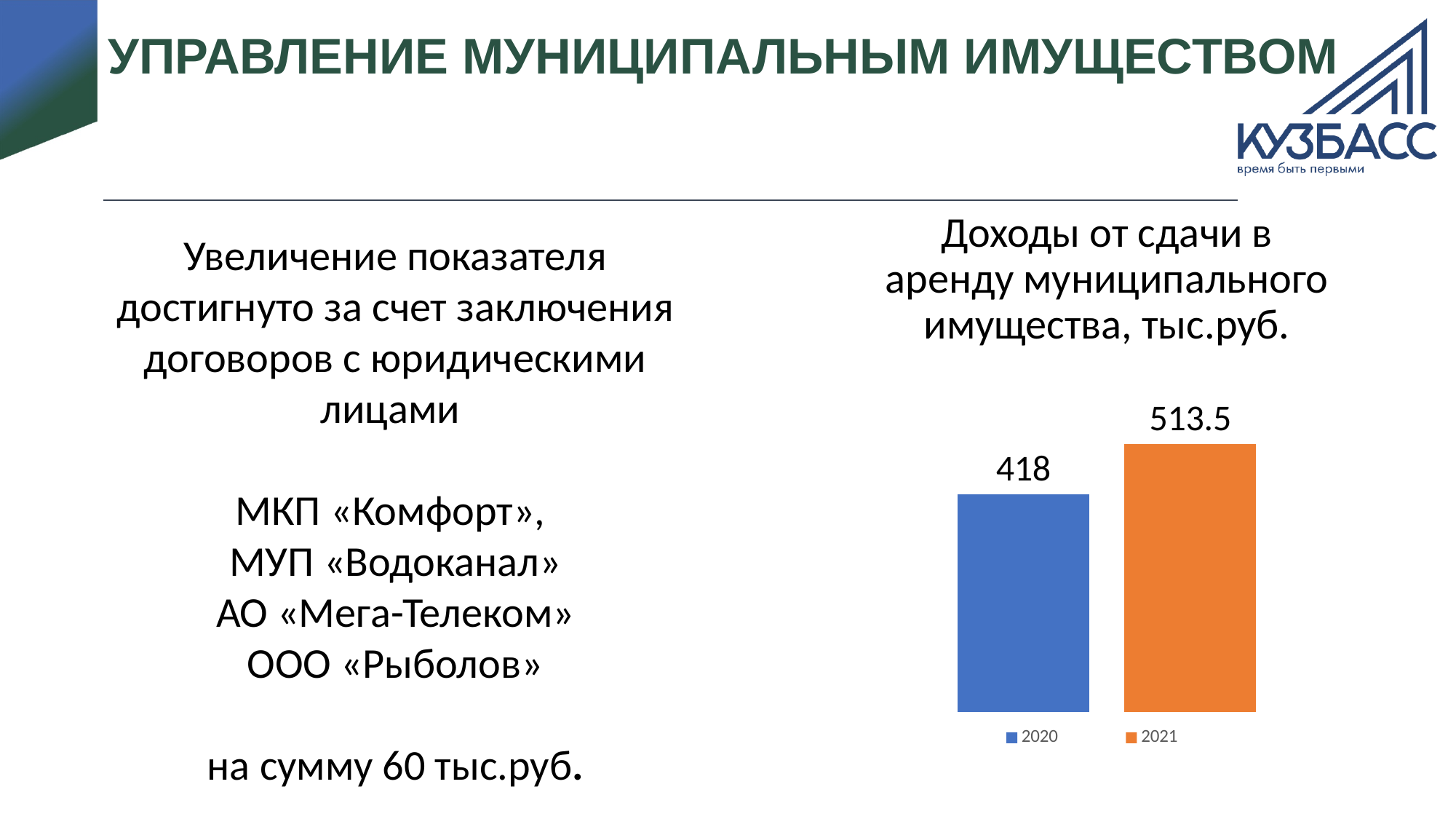
Do the values in the chart rise or fall from 2020 to 2021? rise Which year has the highest value in the chart? 2021 Which year has the lowest value in the chart? 2020 What type of chart is shown on the slide? bar chart What is the value for 2021 in the chart? 513.5 Which is larger in the chart, the value for 2020 or the value for 2021? 2021 How many entries does the chart legend list? 2 What is the title of the chart? Доходы от сдачи в аренду муниципального имущества, тыс.руб. What colour is the bar for 2021 in the chart? orange What is the value for 2020 in the chart? 418 How many bars are shown in the chart? 2 What is the difference between the 2021 and 2020 values in the chart? 95.5